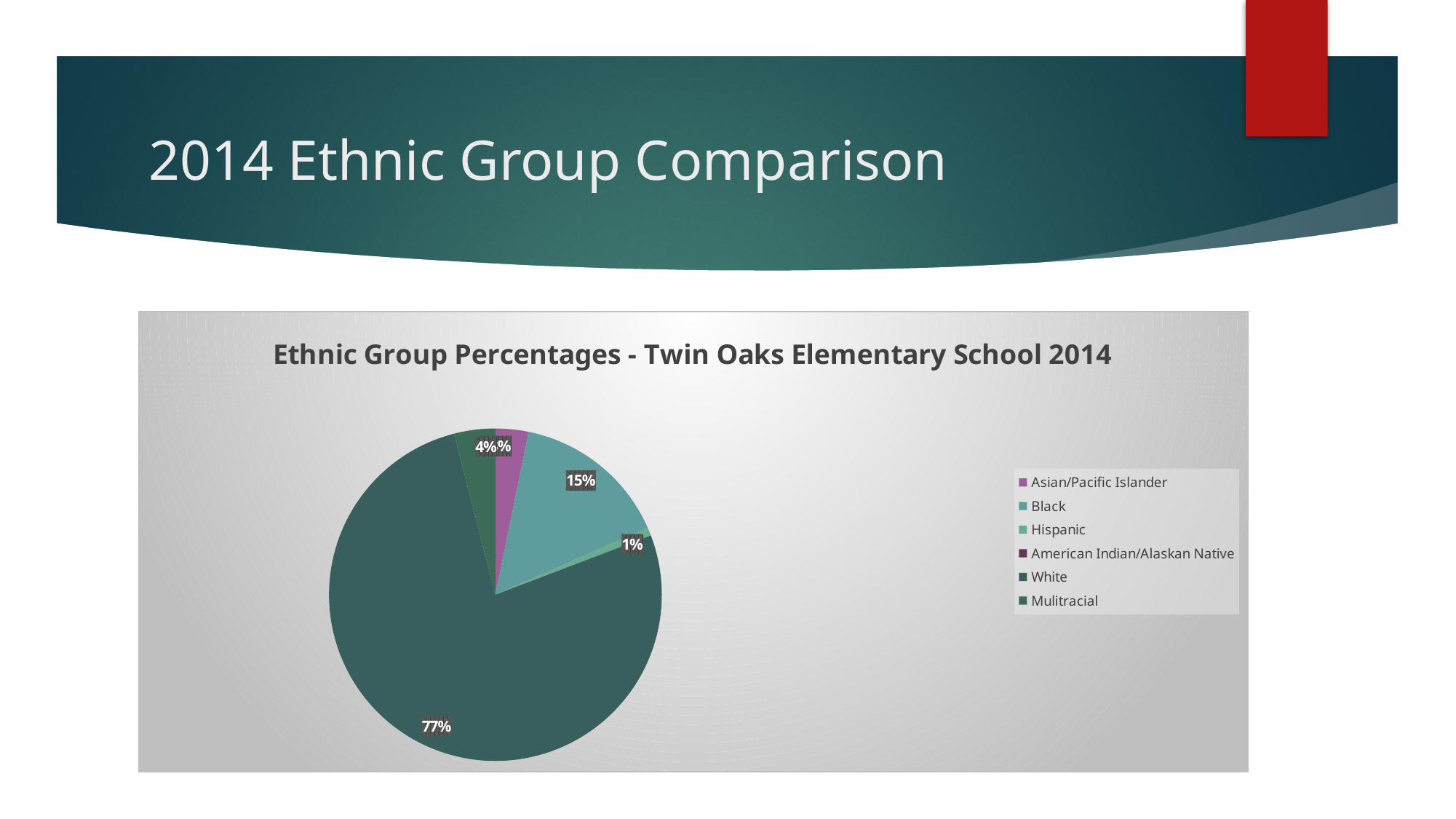
What kind of chart is shown on the slide? Pie chart What is the difference in percentage points between the Black slice and the Hispanic slice? 14 percentage points Which slice is larger, Black or Hispanic? Black What percentage of the pie is the Hispanic group? 1% What percentage of the pie is the Black group? 15% How many ethnic groups are listed in the legend? 6 Which ethnic group is shown in purple in the legend? Asian/Pacific Islander What percentage of the pie is the White group? 77% What is the title of the chart? Ethnic Group Percentages - Twin Oaks Elementary School 2014 Which ethnic group has the largest slice of the pie? White What is the difference in percentage points between the White slice and the Black slice? 62 percentage points Which slice is larger, White or Black? White